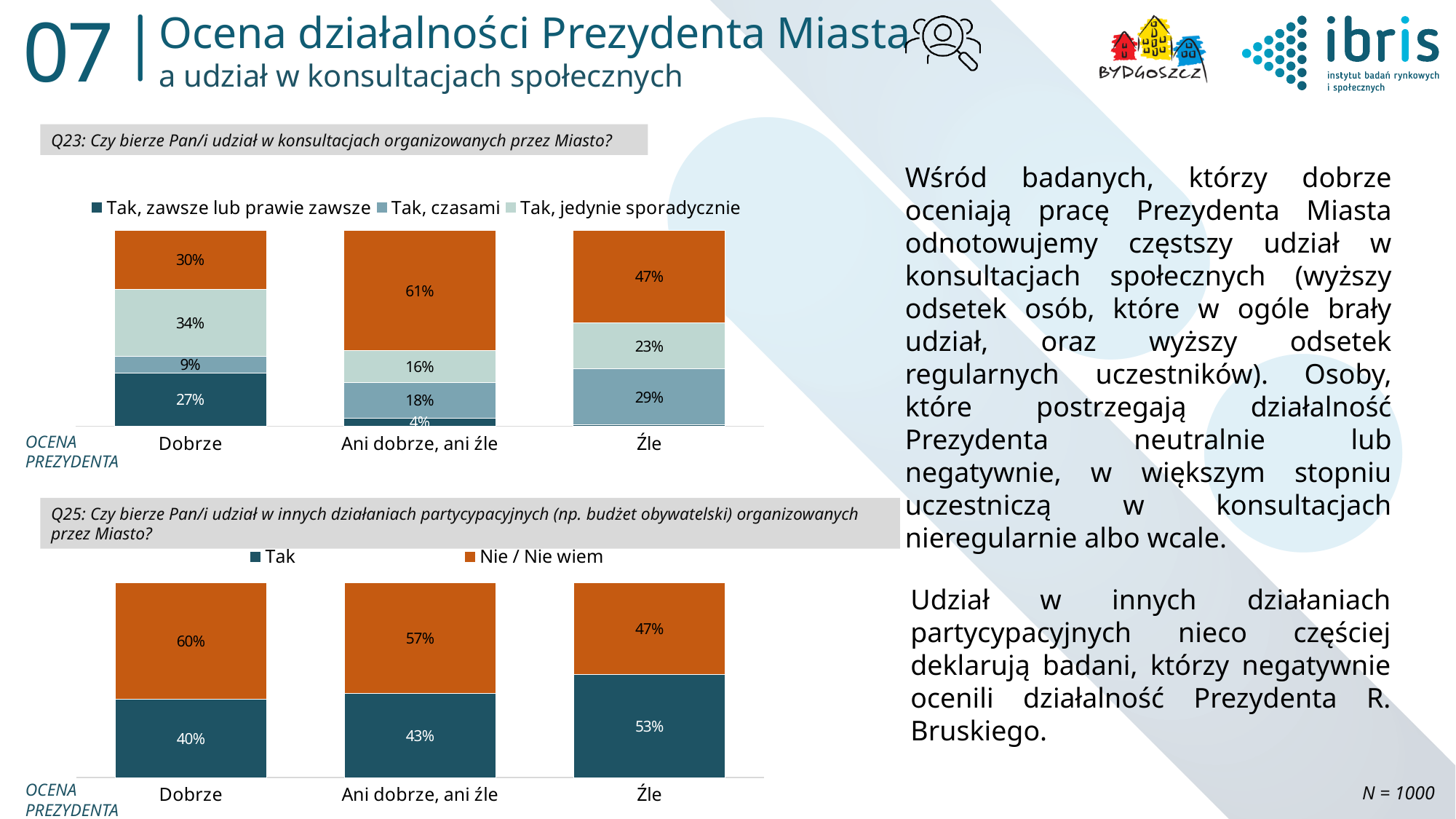
In the Q25 chart (bottom), how many categories are shown on the x axis? 3 What type of chart is the Q25 chart (bottom)? Stacked bar chart In the Q23 chart (top), which category has the largest orange (top) segment? Ani dobrze, ani źle In the Q23 chart (top), what percentage of respondents who rate the President 'Dobrze' answered 'Tak, zawsze lub prawie zawsze'? 27% In the Q25 chart (bottom), what is the 'Nie / Nie wiem' value for 'Dobrze'? 60% In the Q23 chart (top), what is the value of the 'Tak, czasami' segment for 'Ani dobrze, ani źle'? 18% In the Q25 chart (bottom), is the 'Tak' value larger for 'Ani dobrze, ani źle' or for 'Źle'? Źle In the Q25 chart (bottom), which category has the lowest 'Tak' value? Dobrze In the Q23 chart (top), how many entries does the legend list? 3 In the Q23 chart (top), what is the difference between the 'Tak, jedynie sporadycznie' values for 'Dobrze' and 'Ani dobrze, ani źle'? 18 percentage points In the Q23 chart (top), what is the value of the 'Tak, jedynie sporadycznie' segment for 'Źle'? 23% In the Q25 chart (bottom), what percentage of respondents who rate the President 'Źle' answered 'Tak'? 53%